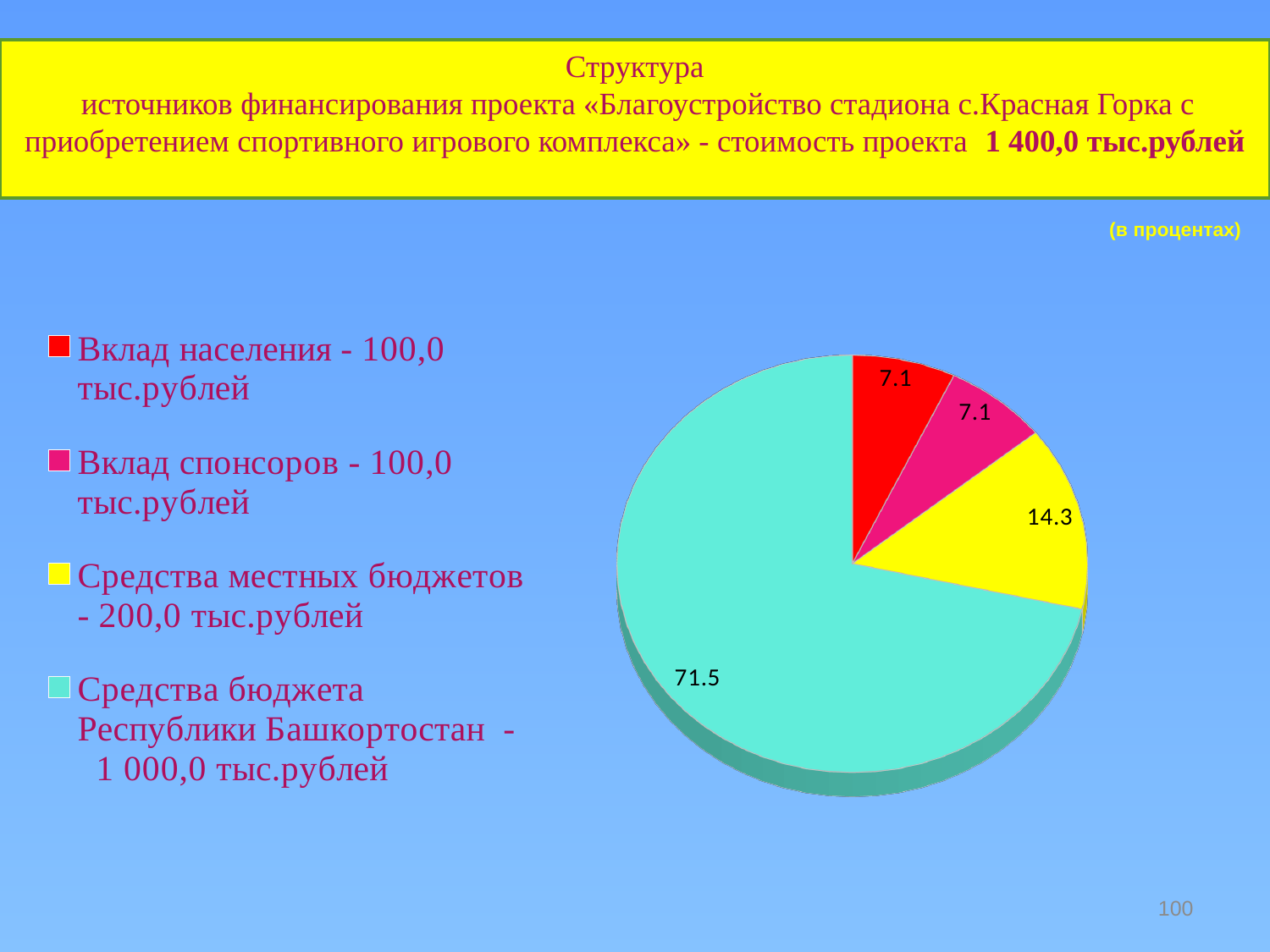
How many entries does the legend list? 4 What kind of chart is shown on the slide? Pie chart What percentage is shown for Вклад спонсоров? 7.1 How many slices does the pie chart have? 4 What percentage is shown for Средства бюджета Республики Башкортостан? 71.5 What colour is the slice for Средства местных бюджетов? Yellow Which funding source has the largest share of the pie? Средства бюджета Республики Башкортостан What is the difference in percentage points between Средства местных бюджетов and Вклад населения? 7.2 What percentage is shown for Вклад населения? 7.1 What percentage is shown for Средства местных бюджетов? 14.3 Which is larger: the share for Средства местных бюджетов or the share for Вклад спонсоров? Средства местных бюджетов What is the difference in percentage points between Средства бюджета Республики Башкортостан and Средства местных бюджетов? 57.2